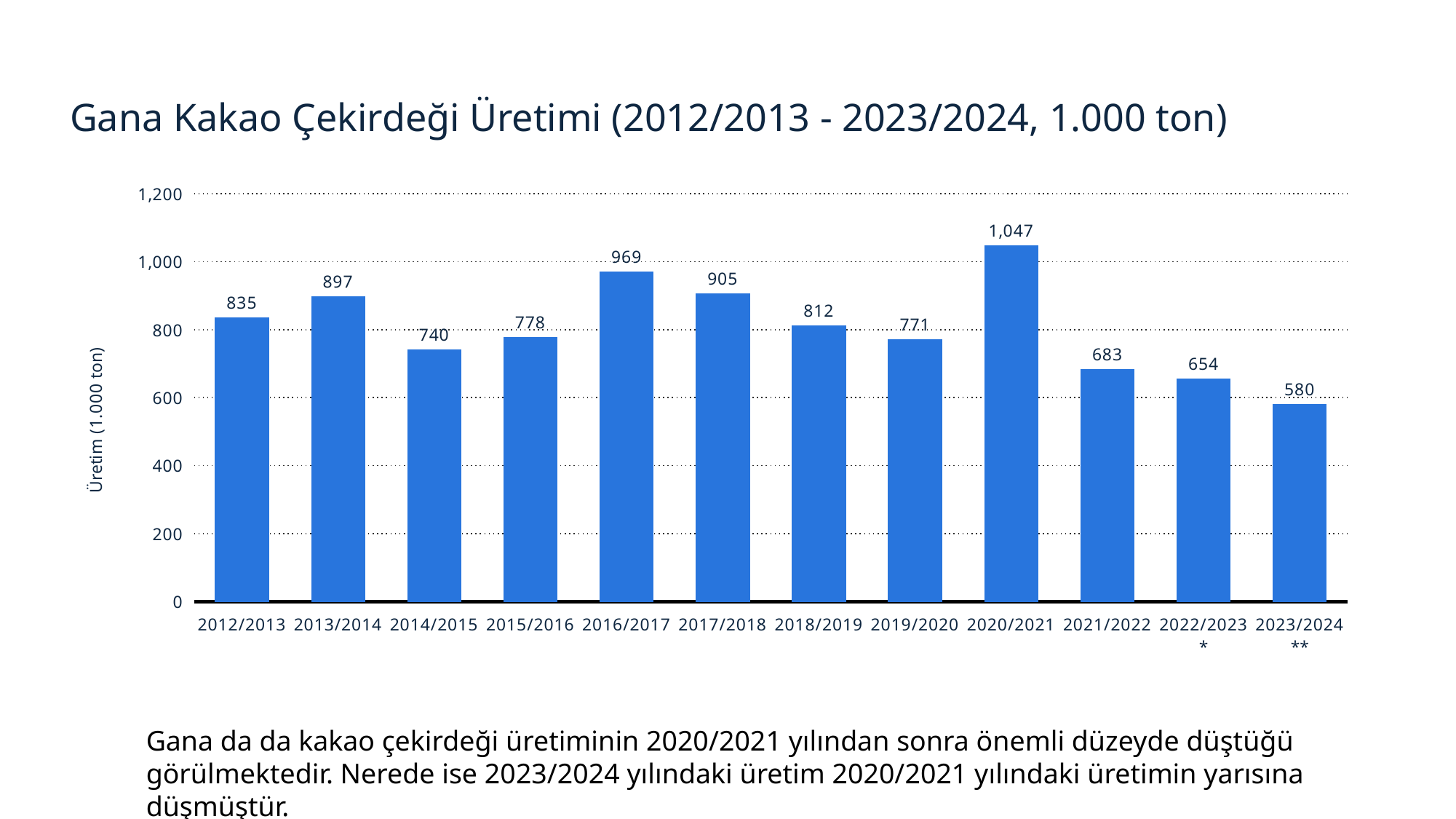
Which season has the lowest production? 2023/2024 Which season has higher production, 2013/2014 or 2017/2018? 2017/2018 What kind of chart is shown on the slide? bar chart Is the value for 2014/2015 greater or less than 800? less What is the difference between the production in 2020/2021 and 2023/2024? 467 Do the values rise or fall from 2020/2021 to 2023/2024? fall What is the label of the y axis? Üretim (1.000 ton) How many seasons are shown on the x axis? 12 What is the cocoa bean production value for 2016/2017? 969 What is the production value shown for 2023/2024? 580 What is the title of the chart? Gana Kakao Çekirdeği Üretimi (2012/2013 - 2023/2024, 1.000 ton) Which season has the highest production? 2020/2021